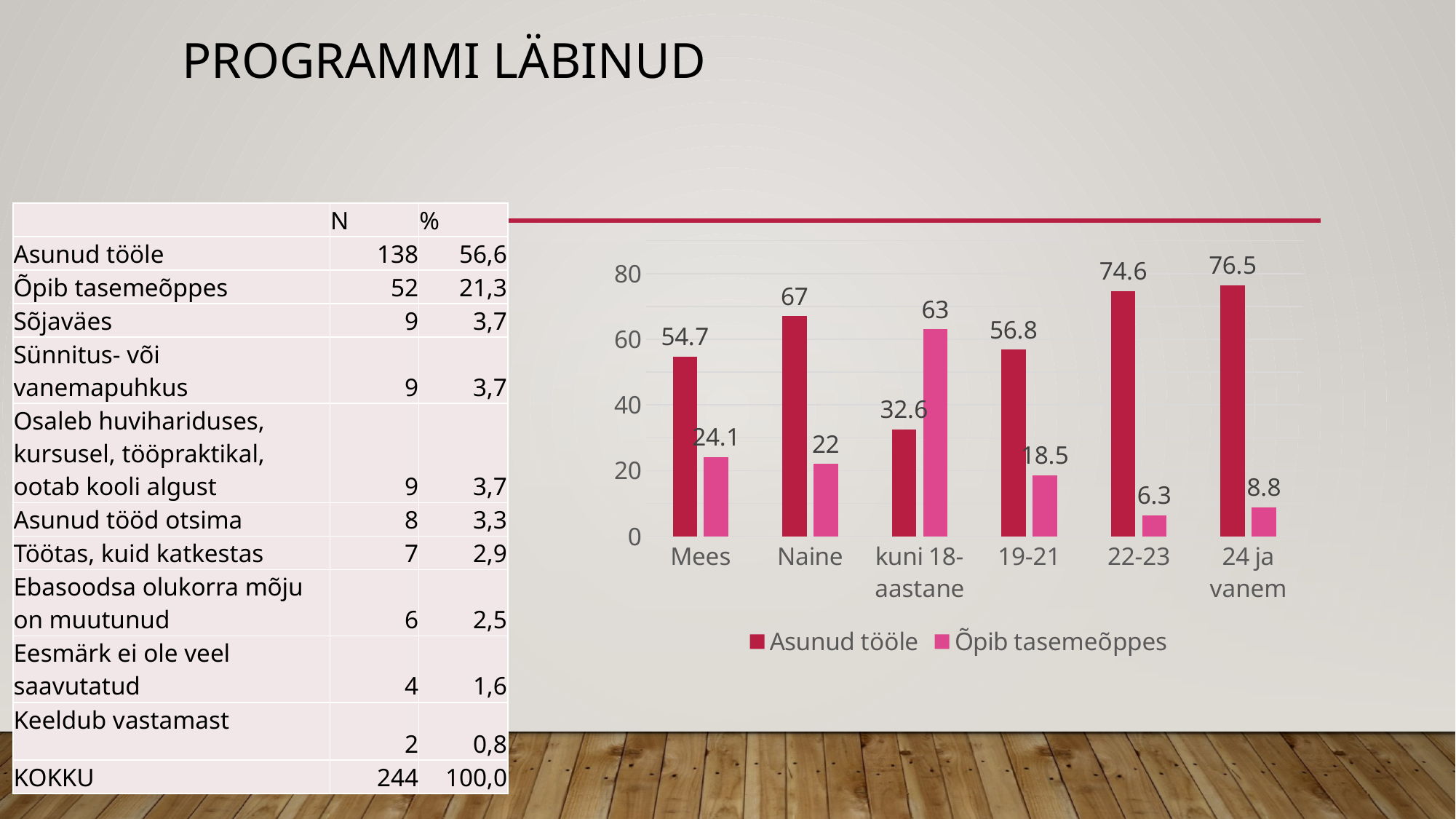
Which category has the lowest value for Õpib tasemeõppes? 22-23 For kuni 18-aastane, which is larger: Asunud tööle or Õpib tasemeõppes? Õpib tasemeõppes Which category has the highest value for Asunud tööle? 24 ja vanem How many categories are shown on the x axis of the chart? 6 What is the value of Õpib tasemeõppes for 24 ja vanem? 8.8 What is the value of Õpib tasemeõppes for kuni 18-aastane? 63 What is the value of Asunud tööle for Mees? 54.7 How many series does the chart legend list? 2 Does the value of Õpib tasemeõppes rise or fall from 19-21 to 22-23? fall What is the value of Asunud tööle for 22-23? 74.6 What kind of chart is shown on the slide? bar chart What is the difference between Asunud tööle for Naine and for Mees? 12.3